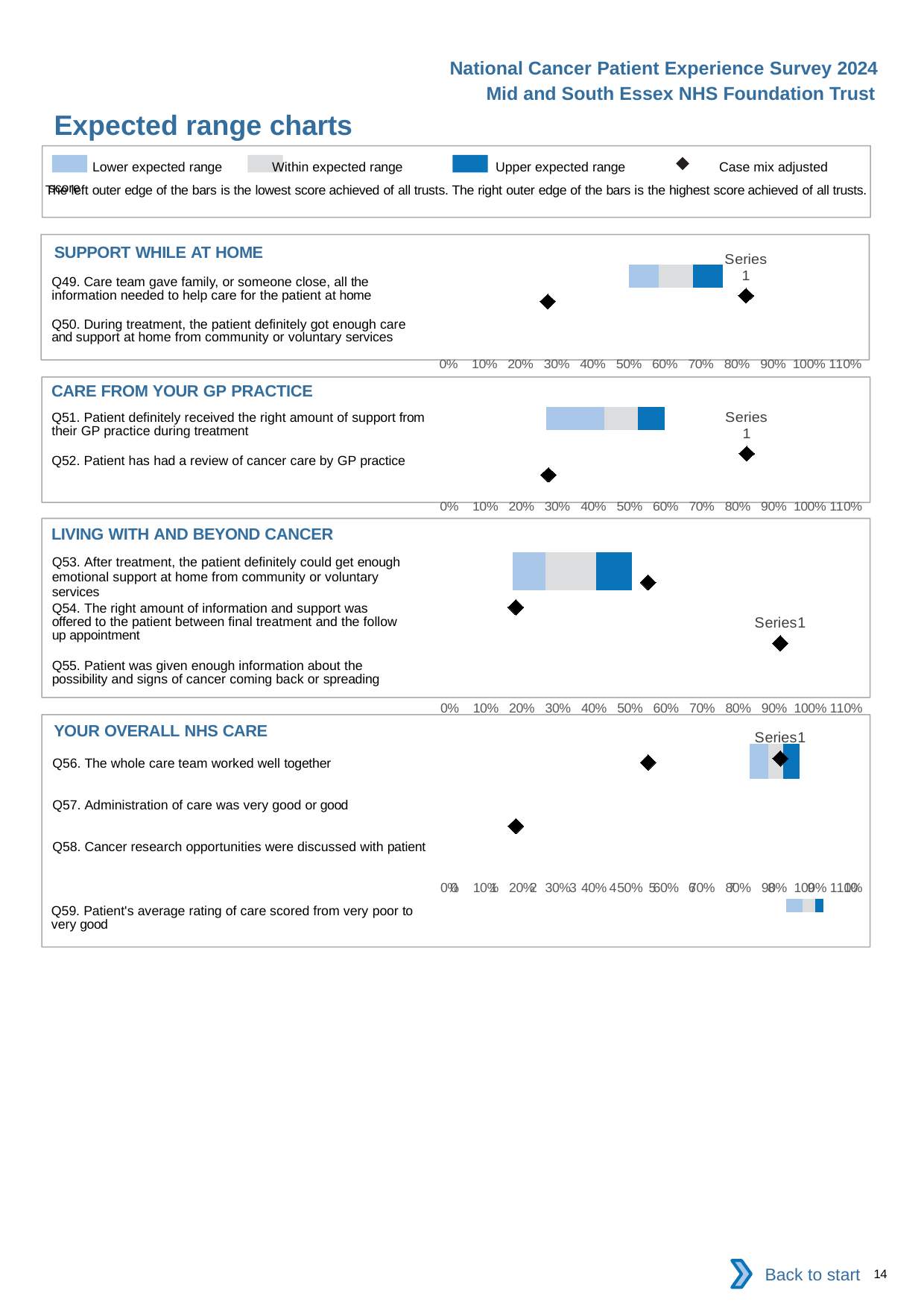
In the LIVING WITH AND BEYOND CANCER chart, is the left edge of the bar greater or less than 30%? less According to the legend, what does the diamond marker represent? Case mix adjusted score How many questions are listed in the CARE FROM YOUR GP PRACTICE section? 2 According to the legend, what does the dark blue colour represent? Upper expected range How many entries does the legend at the top of the slide list? 4 How many questions are listed in the LIVING WITH AND BEYOND CANCER section? 3 In the SUPPORT WHILE AT HOME chart, is the right edge of the bar greater or less than 60%? greater In the CARE FROM YOUR GP PRACTICE chart, is the right edge of the bar greater or less than 50%? greater What kind of chart is used in the SUPPORT WHILE AT HOME section? bar chart How many chart sections are shown on the slide? 4